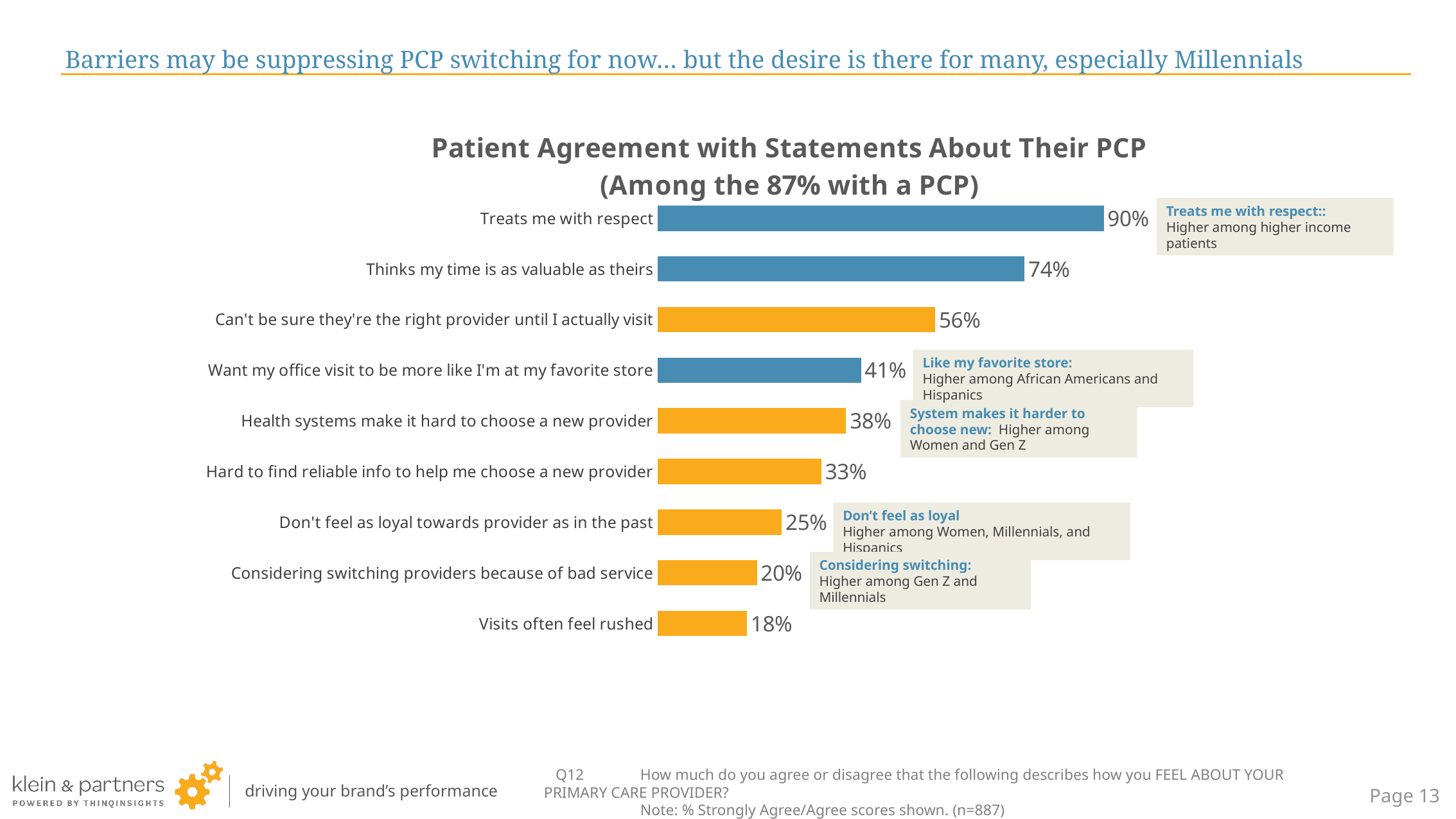
What is the difference between "Treats me with respect" and "Thinks my time is as valuable as theirs"? 16% What percentage agree that health systems make it hard to choose a new provider? 38% What colour is the bar for "Can't be sure they're the right provider until I actually visit"? Orange Which statement has the lowest agreement? Visits often feel rushed What is the title of the chart? Patient Agreement with Statements About Their PCP (Among the 87% with a PCP) What is the value for "Visits often feel rushed"? 18% What percentage of patients agree that their PCP treats them with respect? 90% Which is larger: "Want my office visit to be more like I'm at my favorite store" or "Hard to find reliable info to help me choose a new provider"? Want my office visit to be more like I'm at my favorite store What kind of chart is shown on the slide? Bar chart Which statement has the highest agreement? Treats me with respect What is the difference between "Don't feel as loyal towards provider as in the past" and "Considering switching providers because of bad service"? 5% How many statements are shown in the chart? 9